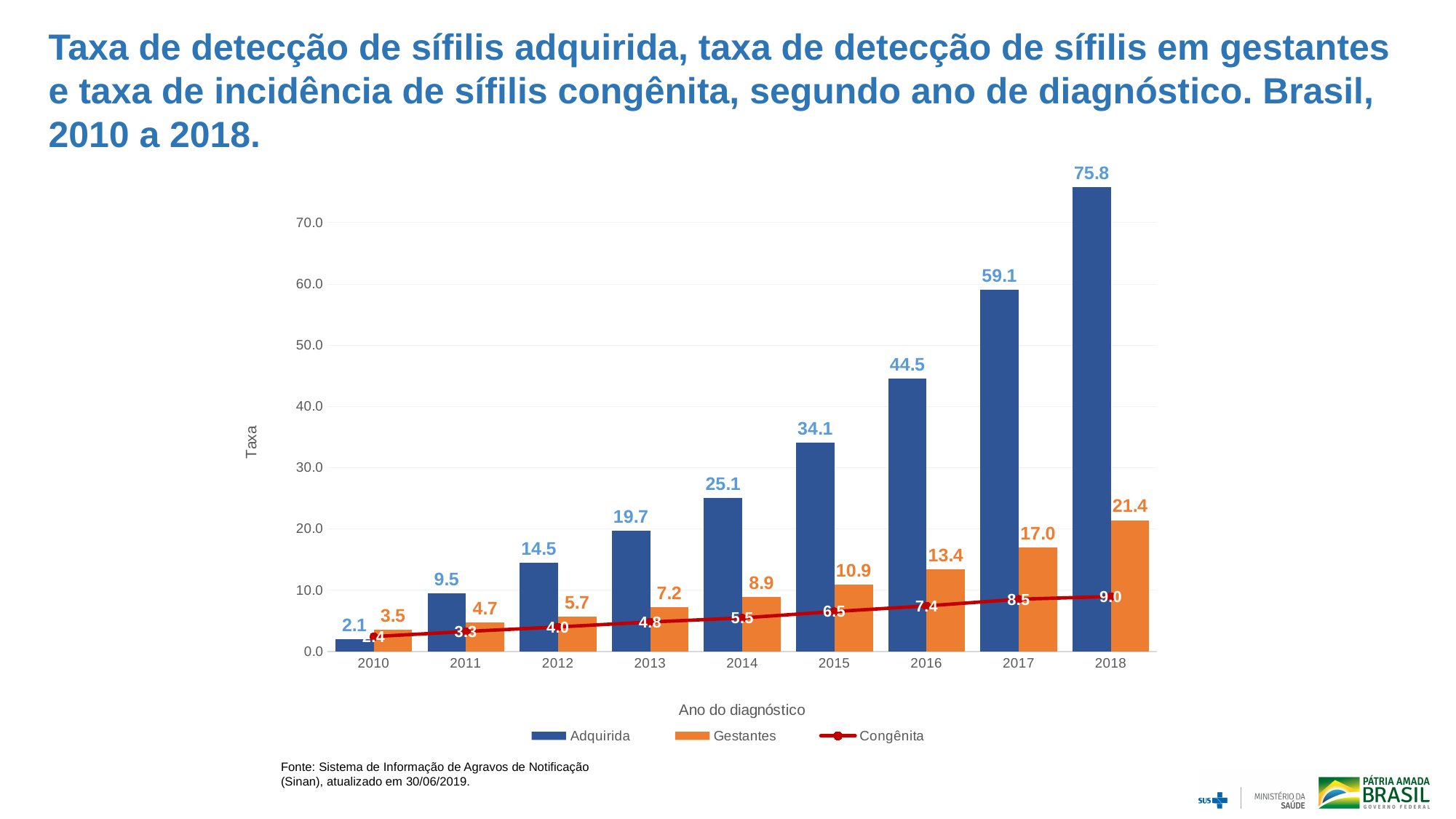
Does the Adquirida series rise or fall from 2010 to 2018? rise How many series does the legend list? 3 Which series is drawn as a line rather than bars? Congênita What is the Congênita value for 2017? 8.5 How many years are shown on the x axis? 9 Which is larger, the Gestantes value for 2016 or the Congênita value for 2016? Gestantes (13.4) Which year has the highest Adquirida value? 2018 What is the Adquirida value for 2013? 19.7 What is the difference between the Adquirida values for 2018 and 2017? 16.7 Which year has the lowest Gestantes value? 2010 What is the Adquirida value for 2018? 75.8 What is the Gestantes value for 2015? 10.9